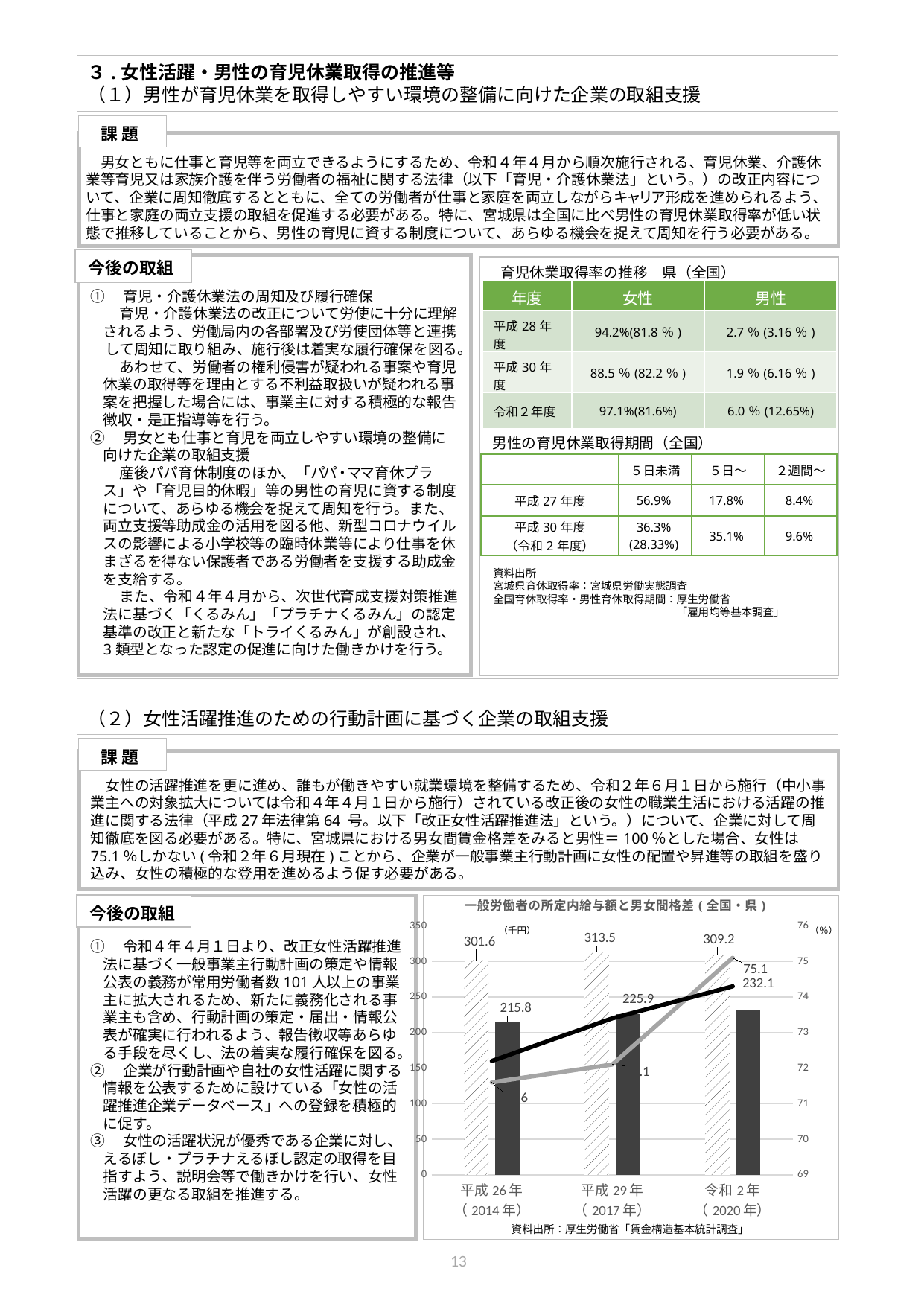
Do the solid dark bars rise or fall from 平成26年 to 令和2年? rise What is the title of the chart? 一般労働者の所定内給与額と男女間格差（全国・県） Which year has the lowest solid dark bar? 平成26年（2014年） Is the solid dark bar for 平成29年（2017年） greater or less than 200? greater What is the difference between the hatched bar and the solid dark bar for 平成26年（2014年）? 85.8 What is the value of the solid dark bar for 令和2年（2020年）? 232.1 What is the value of the solid dark bar for 平成26年（2014年）? 215.8 Which year has the highest hatched bar? 平成29年（2017年） What is the value of the hatched bar for 平成29年（2017年）? 313.5 How many year categories are shown on the x axis? 3 By how much did the solid dark bar increase from 平成26年（2014年） to 令和2年（2020年）? 16.3 Which is larger, the hatched bar for 平成26年（2014年） or for 令和2年（2020年）? 令和2年（2020年）